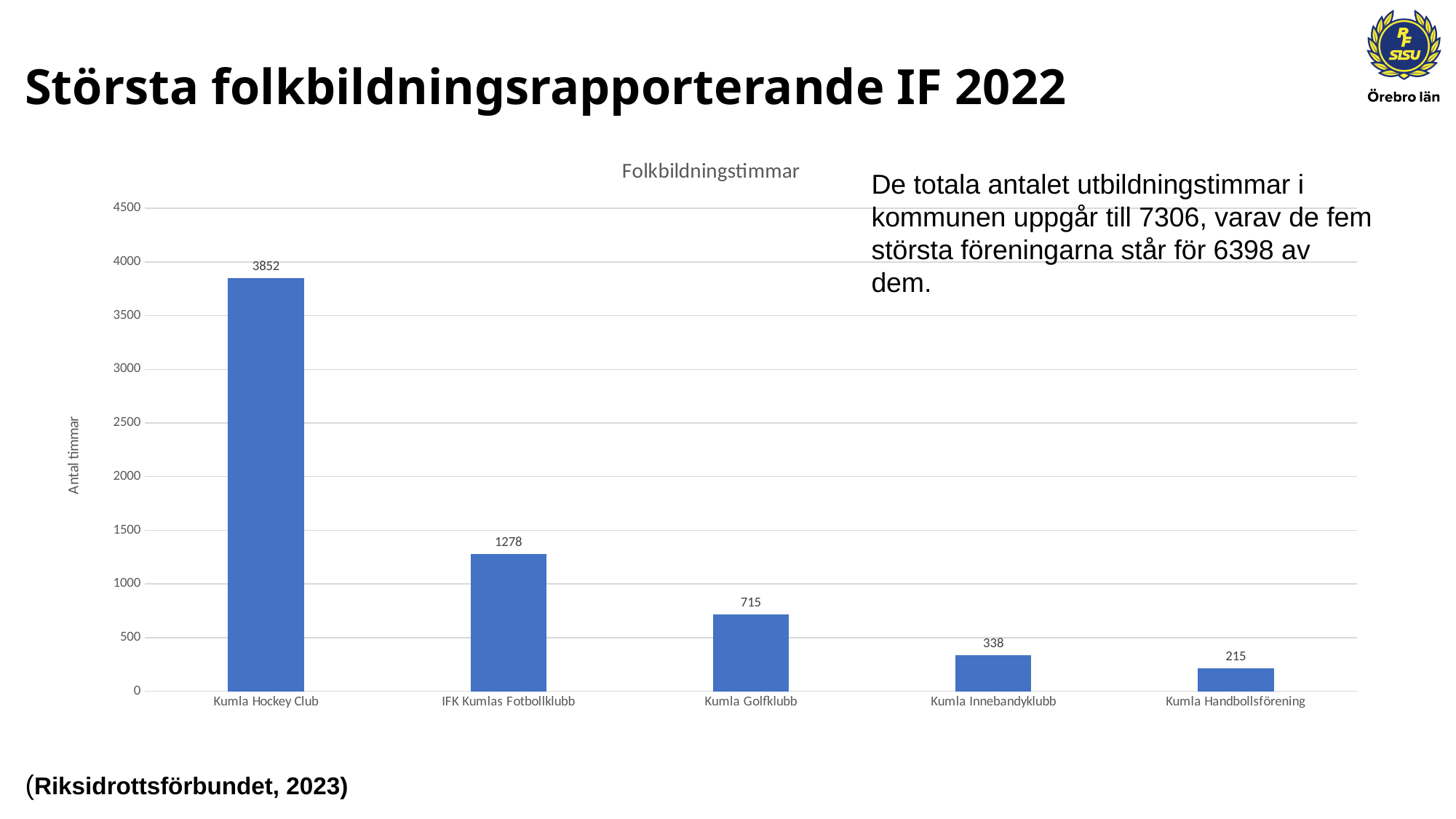
What is the value for Kumla Golfklubb? 715 Is the value for Kumla Innebandyklubb greater or less than 500? less What is the title of the chart? Folkbildningstimmar What is the value for Kumla Hockey Club? 3852 How many categories are shown in the chart? 5 Which category has the lowest value? Kumla Handbollsförening Which is larger, the value for Kumla Innebandyklubb or Kumla Golfklubb? Kumla Golfklubb What is the value for IFK Kumlas Fotbollklubb? 1278 What is the value for Kumla Handbollsförening? 215 Which category has the highest value? Kumla Hockey Club What is the difference between the values for Kumla Hockey Club and IFK Kumlas Fotbollklubb? 2574 What kind of chart is shown on the slide? bar chart